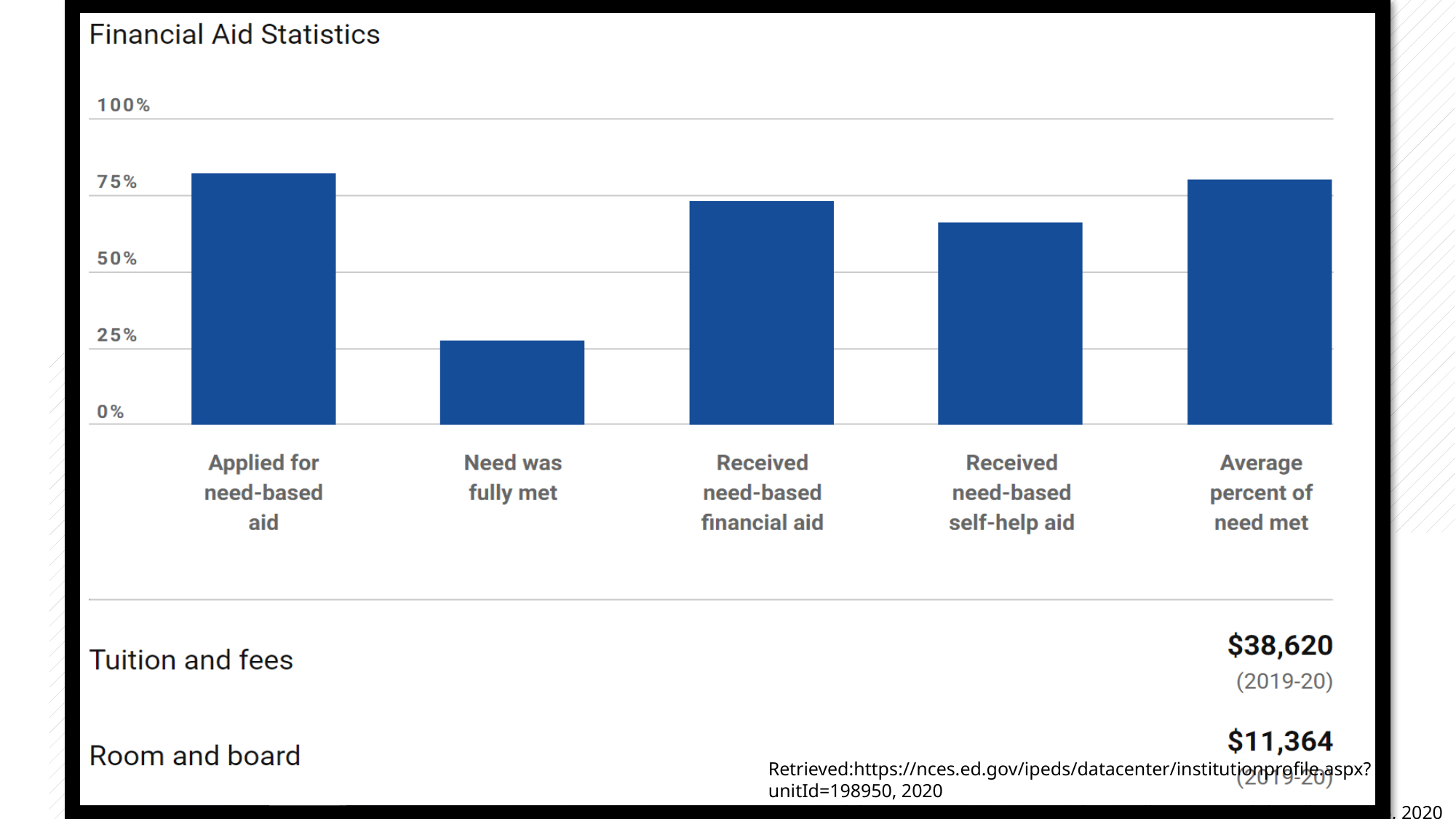
Which is larger: Applied for need-based aid or Need was fully met? Applied for need-based aid What is the highest value shown on the y axis of the chart? 100% Is the value for Received need-based financial aid greater or less than 75%? less What is the title of the chart? Financial Aid Statistics Which category has the lowest value? Need was fully met Is the value for Applied for need-based aid greater or less than 75%? greater Is the value for Received need-based self-help aid greater or less than 50%? greater Which is larger: Received need-based financial aid or Received need-based self-help aid? Received need-based financial aid What kind of chart is shown on the slide? bar chart How many categories are plotted in the chart? 5